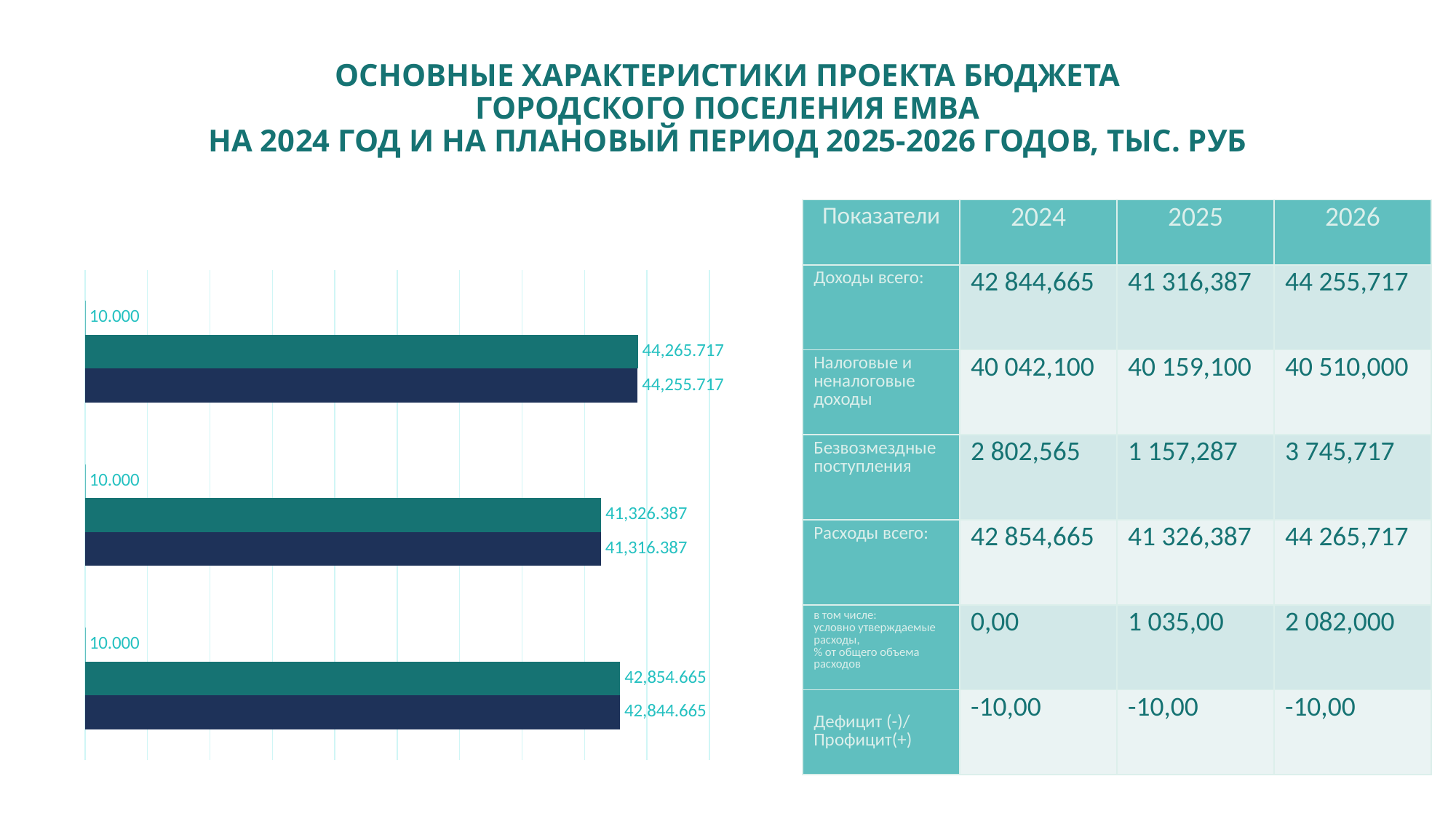
In the bar chart, what is the value labelled on the teal bar in the middle group? 41,326.387 In the bar chart, what is the value labelled on the dark navy bar in the middle group? 41,316.387 In the bar chart, what is the value labelled on the top dark navy bar? 44,255.717 What kind of chart is shown on the left of the slide? bar chart In the bar chart, how many groups of bars are shown? 3 In the bar chart, what is the difference between the top teal bar (44,265.717) and the top dark navy bar (44,255.717)? 10.000 In the bar chart, what is the value labelled on the dark navy bar in the bottom group? 42,844.665 In the bar chart, what is the value labelled on the top teal bar? 44,265.717 In the bar chart, which labelled bar value is the largest? 44,265.717 In the bar chart, which labelled bar value is the smallest among the teal and dark navy bars? 41,316.387 In the bar chart, what is the value labelled on the teal bar in the bottom group? 42,854.665 In the bar chart, what value is printed above each group of bars? 10.000